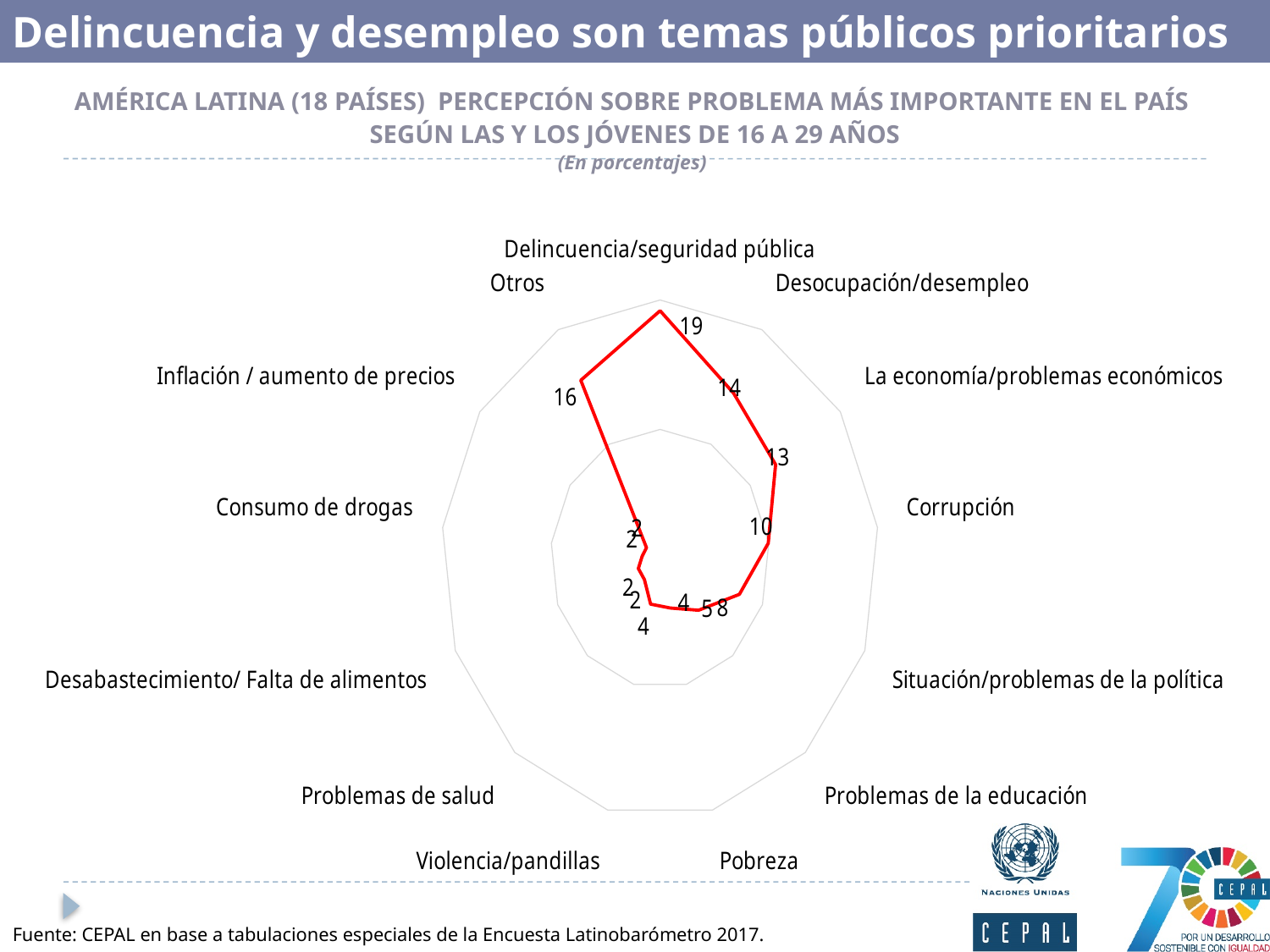
What kind of chart is this? Radar chart Which is larger, the value for Otros or the value for Desocupación/desempleo? Otros What is the value for Otros? 16 What is the value for Situación/problemas de la política? 8 What is the value for La economía/problemas económicos? 13 What is the value for Corrupción? 10 How many categories are shown on the chart? 13 Which category has the highest value? Delincuencia/seguridad pública What is the difference between the values for Delincuencia/seguridad pública and Desocupación/desempleo? 5 In what unit are the values expressed, according to the chart subtitle? En porcentajes What is the value for Delincuencia/seguridad pública? 19 What is the value for Desocupación/desempleo? 14